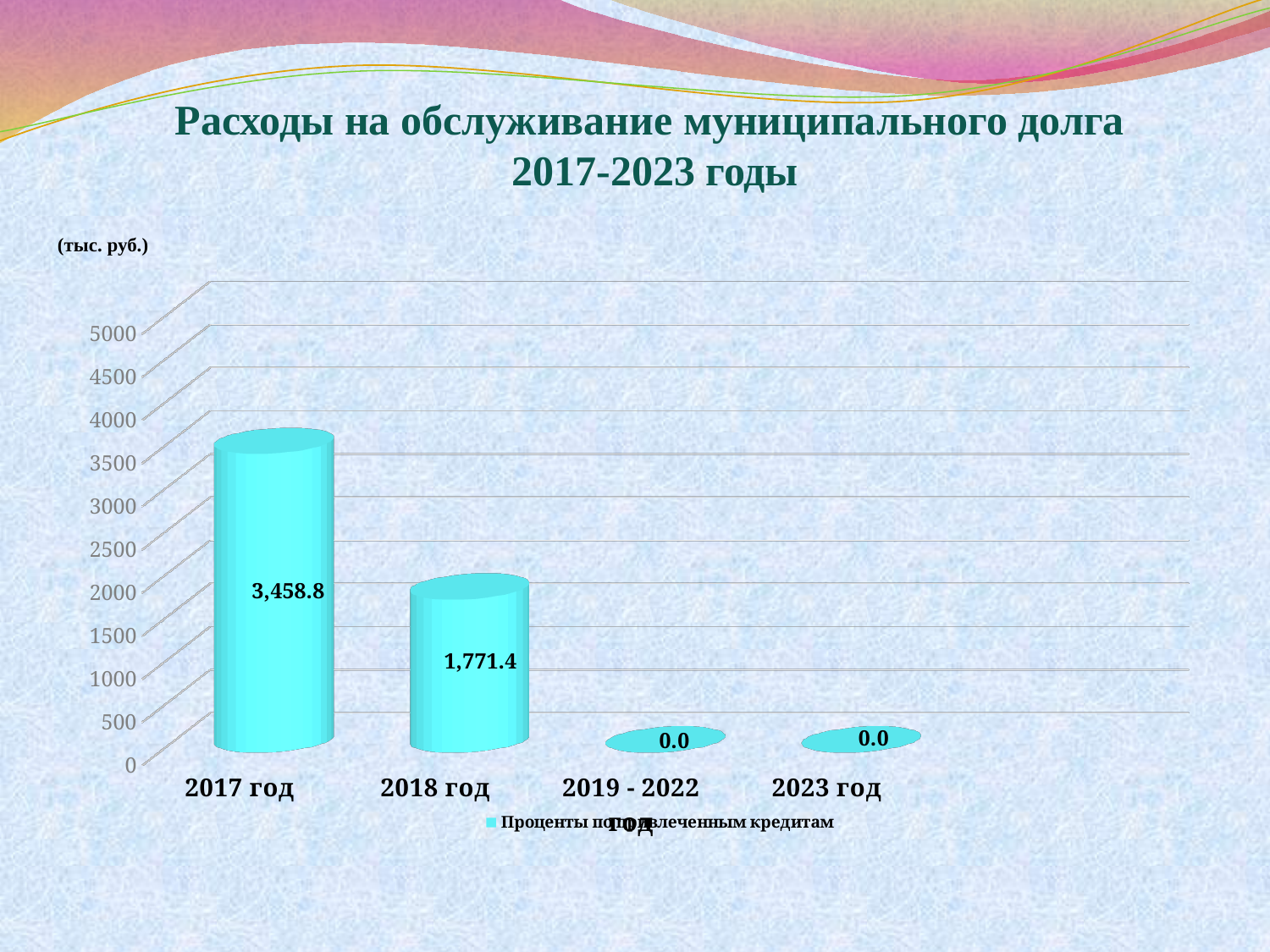
What kind of chart is shown on the slide? bar chart How many categories are shown on the x axis? 4 How many series does the legend list? 1 Which category has the highest value? 2017 год What is the value for 2017 год? 3,458.8 What is the difference between the values for 2017 год and 2018 год? 1,687.4 What is the value for 2018 год? 1,771.4 Is the value for 2018 год greater or less than 2000? less Do the values rise or fall from 2017 год to 2018 год? fall Which is larger, the value for 2017 год or the value for 2018 год? 2017 год What is the value for 2023 год? 0.0 What unit is indicated for the values on the chart? тыс. руб.